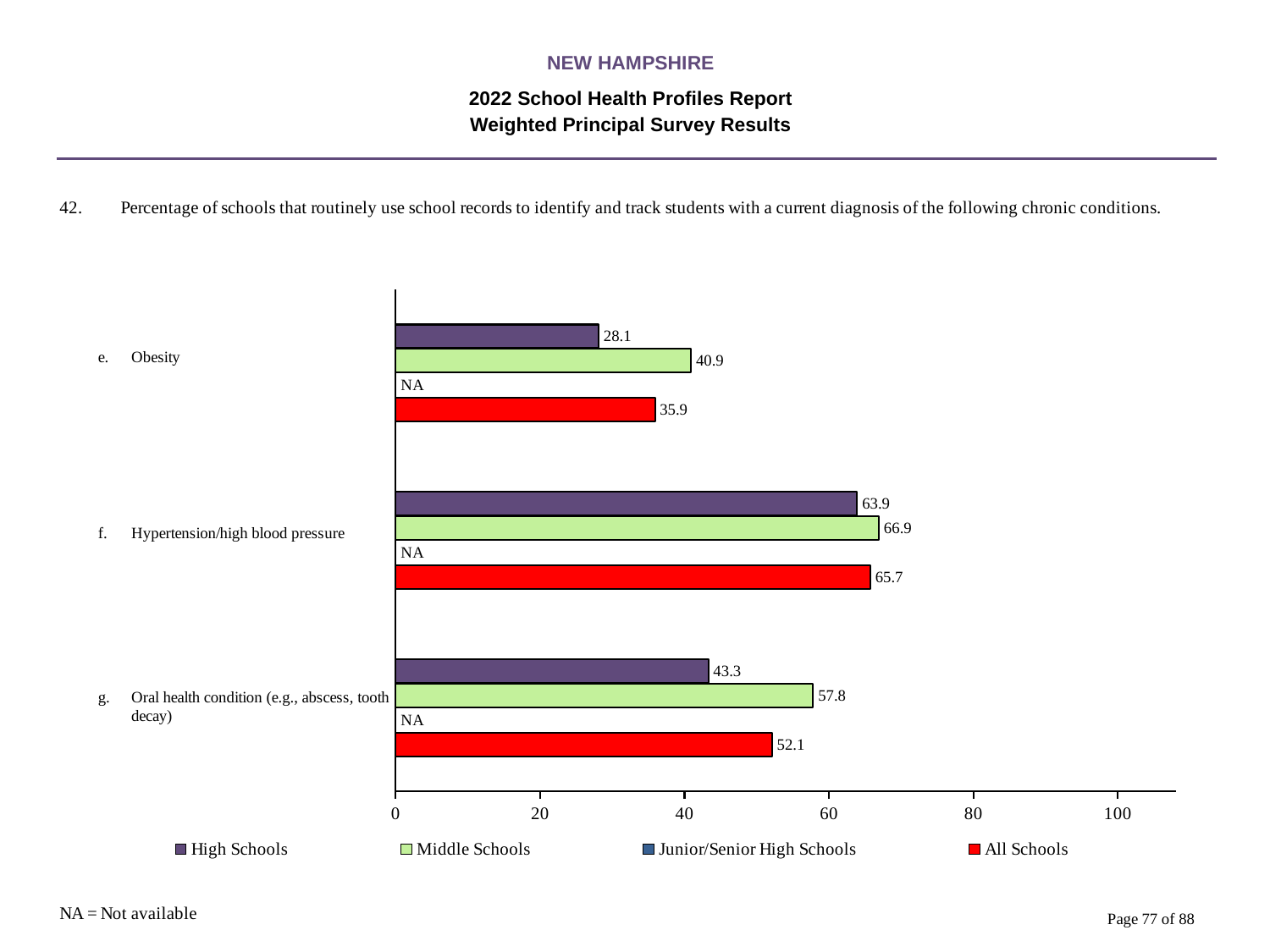
What is the value for Middle Schools for Hypertension/high blood pressure? 66.9 What is the value for High Schools for Obesity? 28.1 Is the Middle Schools value for Obesity greater or less than 40? greater Which chronic condition has the lowest High Schools value? Obesity How many chronic conditions are shown on the chart? 3 What is shown for Junior/Senior High Schools for Obesity? NA What is the value for All Schools for Oral health condition (e.g., abscess, tooth decay)? 52.1 Which chronic condition has the highest All Schools value? Hypertension/high blood pressure How many series does the legend list? 4 Which is larger for Hypertension/high blood pressure: the High Schools value or the All Schools value? All Schools What kind of chart is shown on the slide? bar chart What is the difference between the Middle Schools and High Schools values for Oral health condition (e.g., abscess, tooth decay)? 14.5